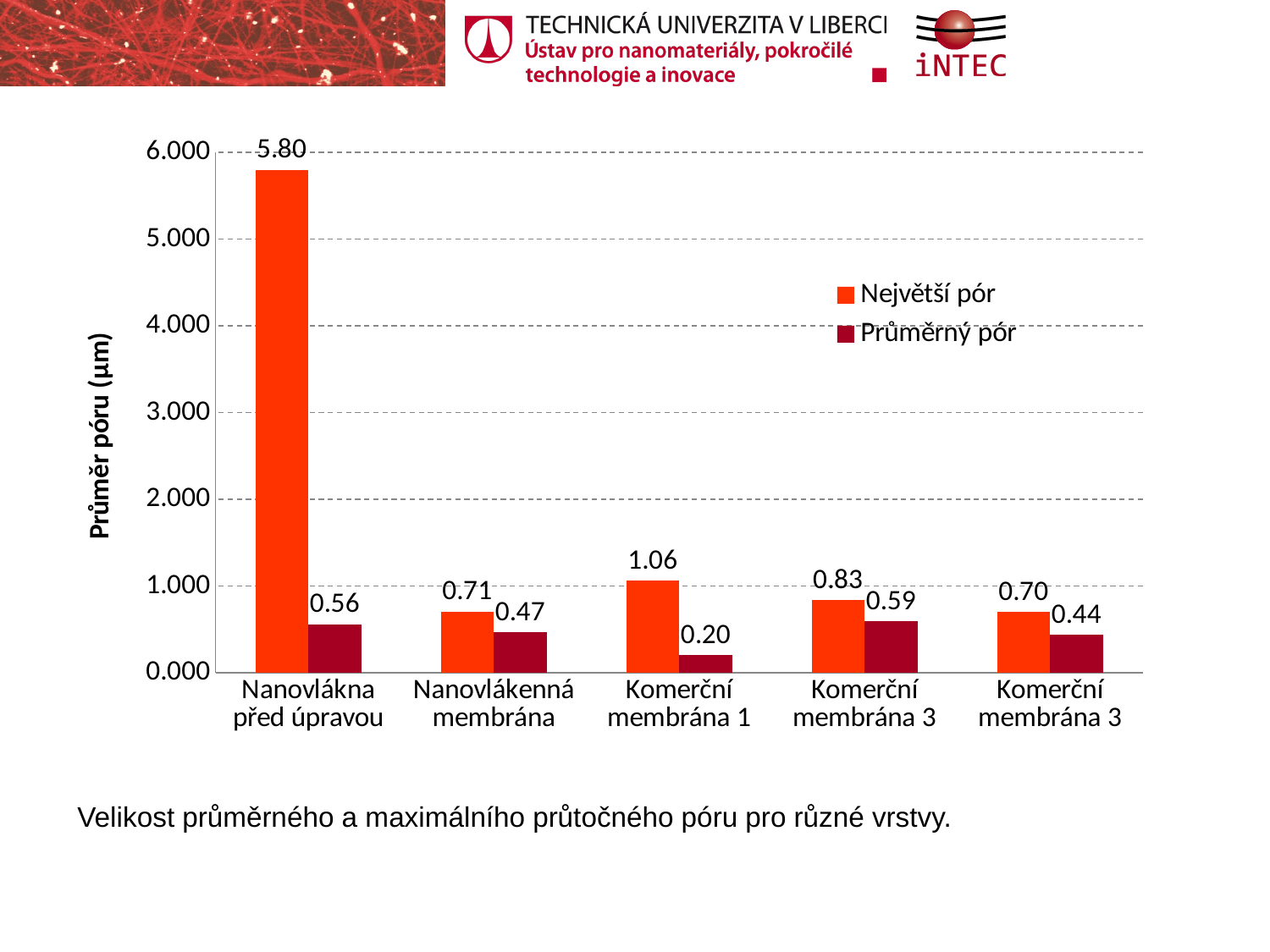
What is the value of Největší pór for Nanovlákna před úpravou? 5.80 Which is larger: the Největší pór value for Komerční membrána 1 or for Nanovlákenná membrána? Komerční membrána 1 Is the Největší pór value for Nanovlákna před úpravou greater or less than 5.000? greater How many categories are shown on the x axis? 5 What is the value of Největší pór for Komerční membrána 1? 1.06 Which category has the highest Největší pór value? Nanovlákna před úpravou What is the difference between the Největší pór and Průměrný pór values for Nanovlákna před úpravou? 5.24 How many series does the legend list? 2 What is the value of Průměrný pór for Nanovlákenná membrána? 0.47 What is the label of the y axis? Průměr póru (µm) What is the value of Průměrný pór for Komerční membrána 1? 0.20 Which category has the lowest Průměrný pór value? Komerční membrána 1